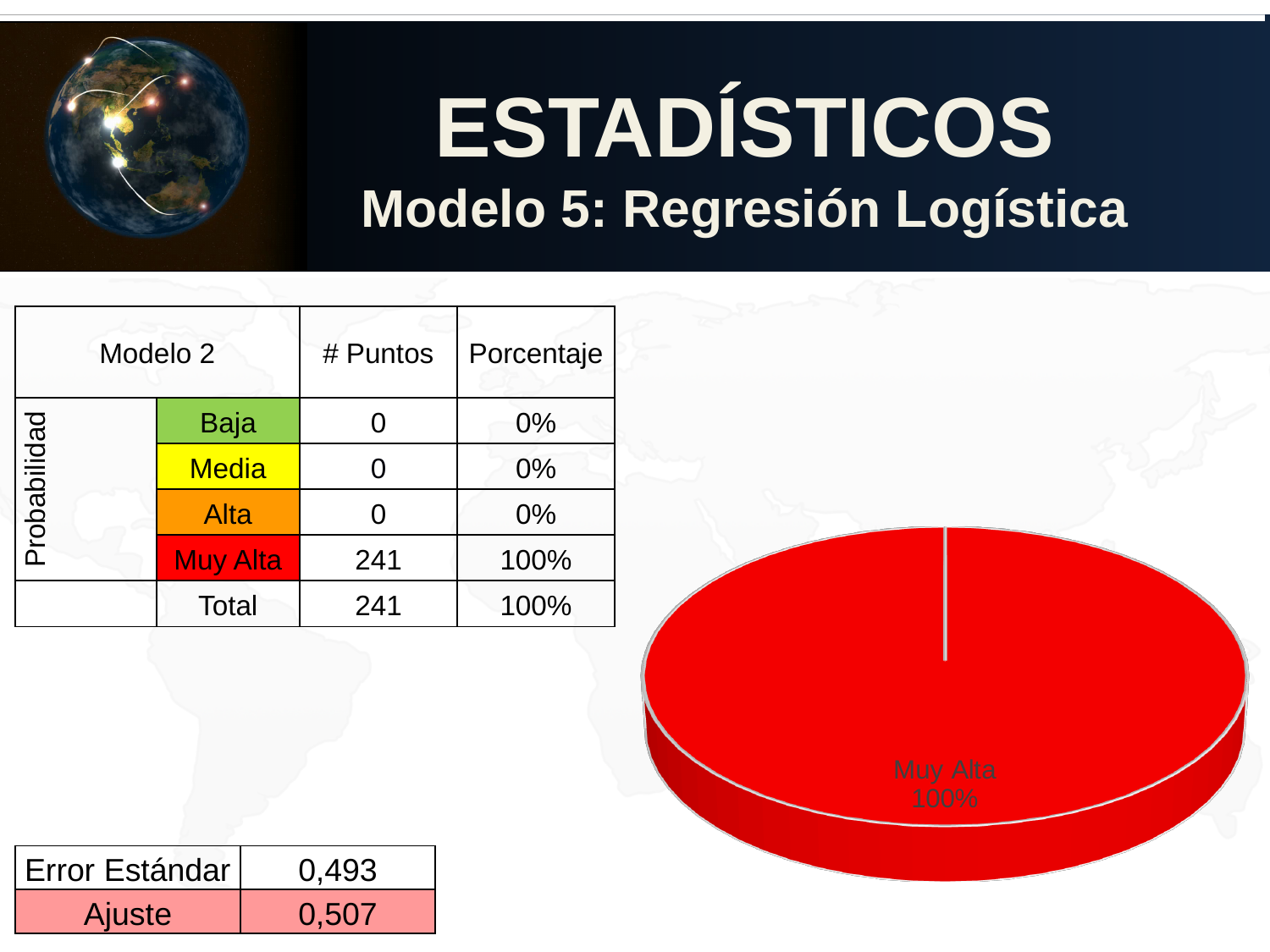
What colour is the Muy Alta slice in the pie chart? red Which category is the largest slice in the pie chart? Muy Alta What share of the pie chart does the Muy Alta slice represent? 100% Which category label appears on the pie chart? Muy Alta What kind of chart is shown on the right side of the slide? pie chart How many labelled slices does the pie chart show? 1 What is the percentage label shown on the Muy Alta slice of the pie chart? 100%